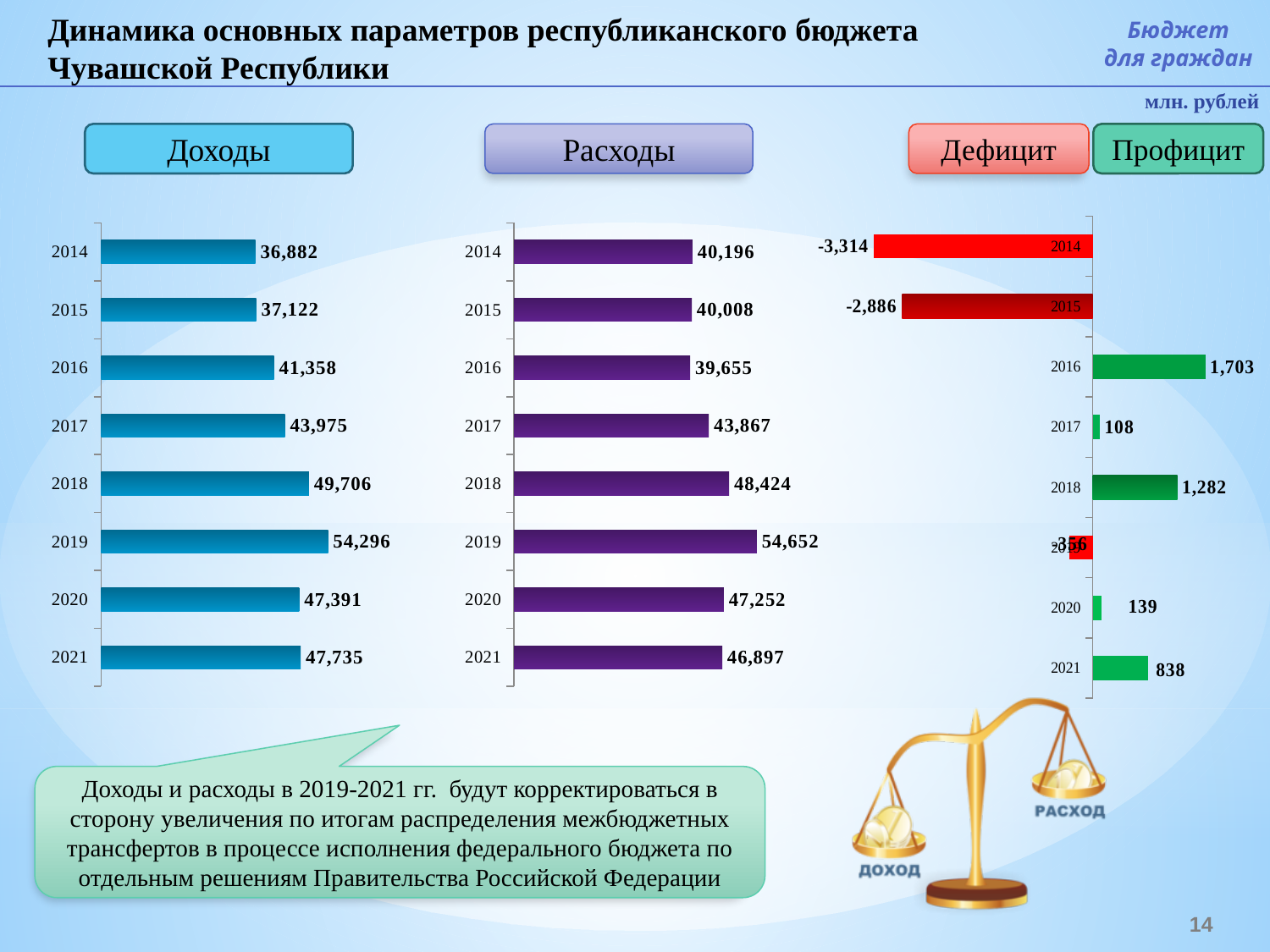
In the Дефицит/Профицит chart, what is the value for 2014? -3,314 In the Расходы chart, which is larger, the value for 2014 or the value for 2015? 2014 In the Доходы chart, what is the value for 2018? 49,706 In the Дефицит/Профицит chart, what is the value for 2016? 1,703 In the Дефицит/Профицит chart, what colour are the Профицит bars? green How many years are shown in the Доходы chart? 8 In the Расходы chart, which year has the highest value? 2019 In the Доходы chart, what is the difference between the values for 2021 and 2020? 344 In the Доходы chart, which year has the lowest value? 2014 In the Доходы chart, which year has the highest value? 2019 In the Расходы chart, what is the value for 2016? 39,655 What kind of chart is the Расходы chart? bar chart